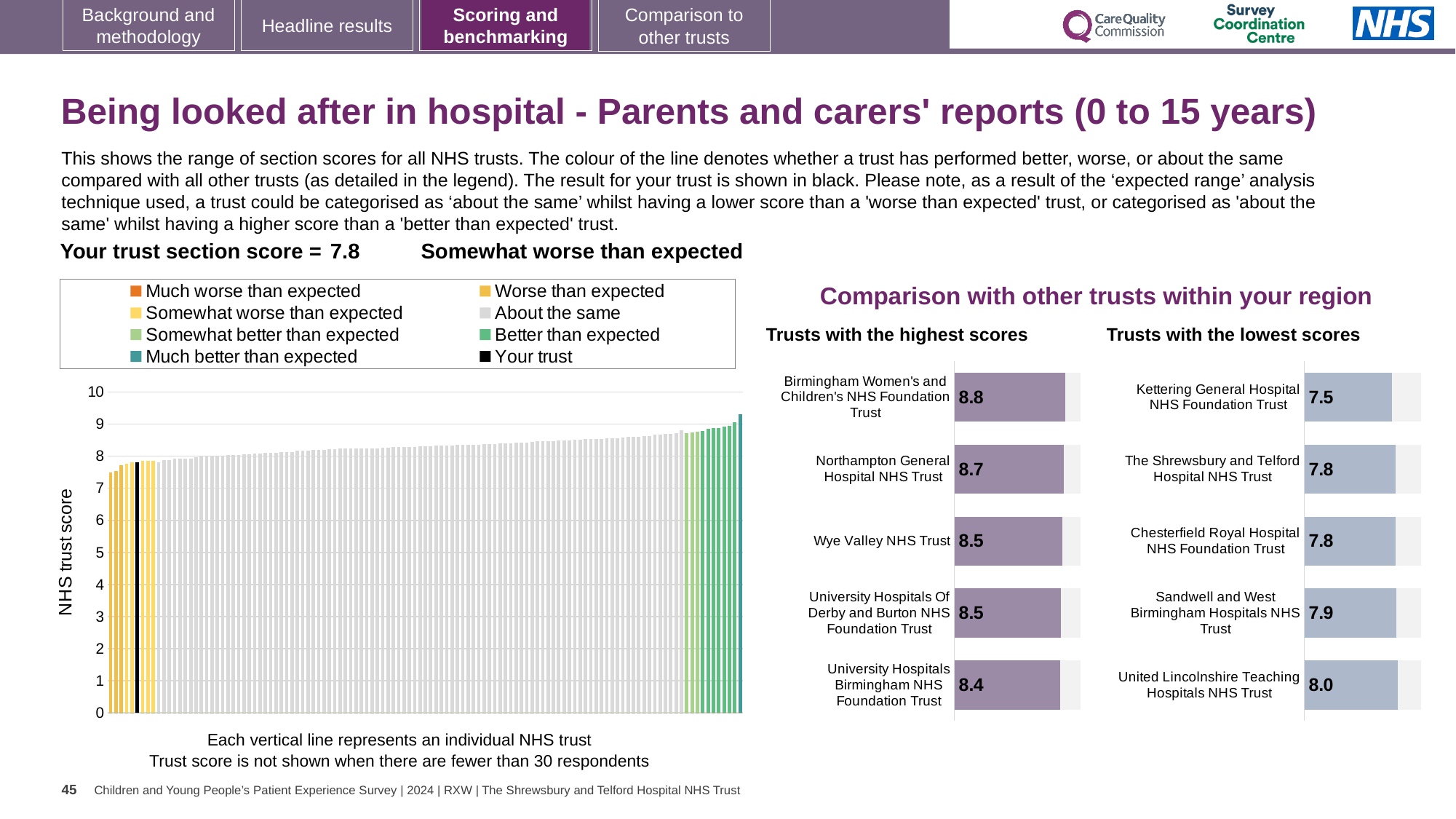
How many entries does the legend of the NHS trust score chart list? 8 In the 'Trusts with the lowest scores' chart, what is the score for Kettering General Hospital NHS Foundation Trust? 7.5 In the 'Trusts with the highest scores' chart, what is the score for Birmingham Women's and Children's NHS Foundation Trust? 8.8 In the 'Trusts with the lowest scores' chart, which has the higher score: Sandwell and West Birmingham Hospitals NHS Trust or Kettering General Hospital NHS Foundation Trust? Sandwell and West Birmingham Hospitals NHS Trust What kind of chart is the NHS trust score chart on the left of the slide? bar chart In the 'Trusts with the lowest scores' chart, which trust has the lowest score? Kettering General Hospital NHS Foundation Trust What is the section score for your trust shown on the slide? 7.8 In the NHS trust score chart, do the trust scores rise or fall from left to right? rise In the NHS trust score chart, is the value of the black 'Your trust' bar greater or less than 5? greater How many trusts are listed in the 'Trusts with the highest scores' chart? 5 In the 'Trusts with the highest scores' chart, what is the difference between the scores of Birmingham Women's and Children's NHS Foundation Trust and University Hospitals Birmingham NHS Foundation Trust? 0.4 In the 'Trusts with the highest scores' chart, which trust has the highest score? Birmingham Women's and Children's NHS Foundation Trust